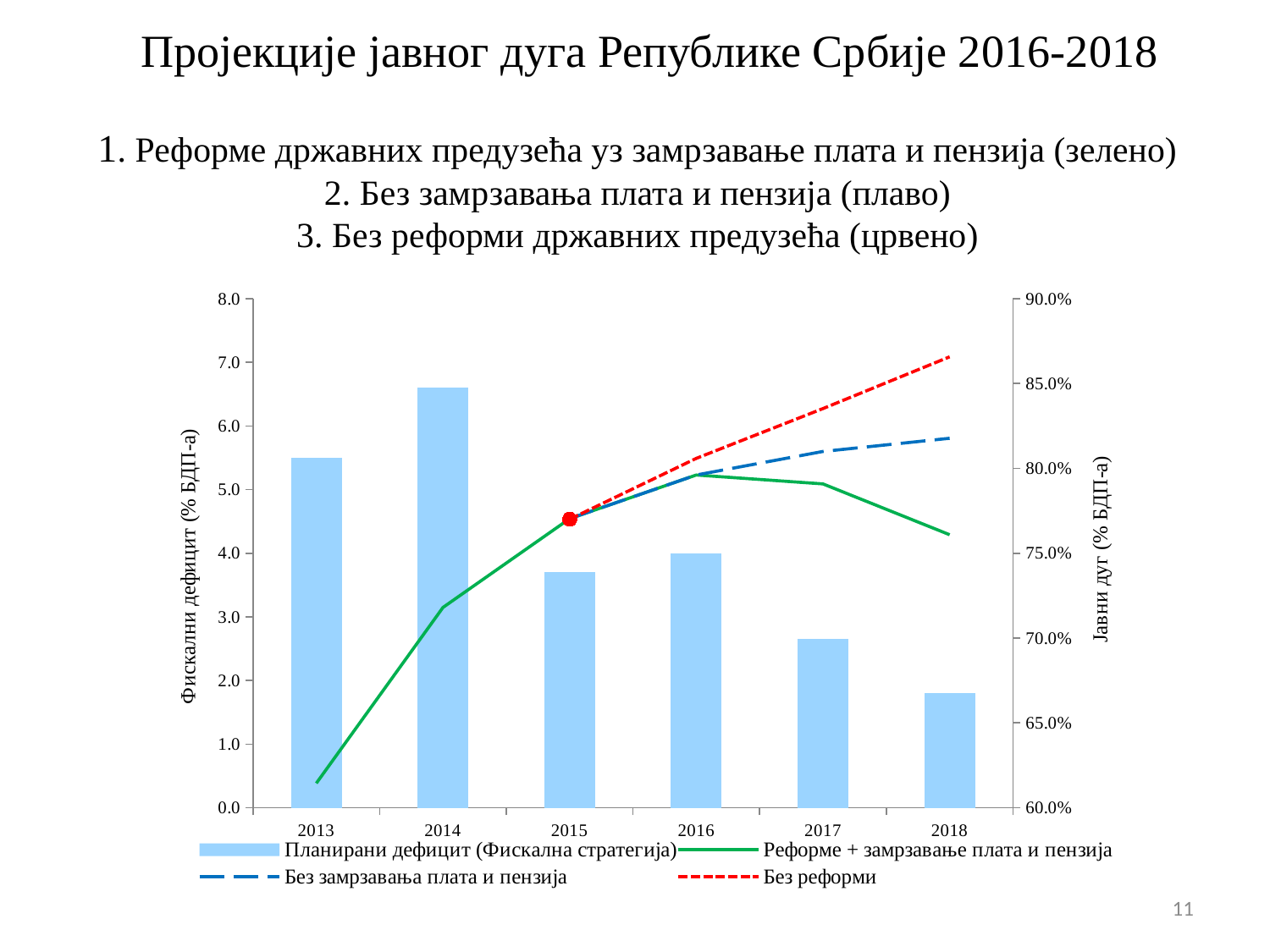
Which is larger, the planned deficit bar for 2013 or for 2015? 2013 What kind of chart is shown on the slide? A combination bar and line chart Is the 'Без реформи' (red dashed) line value for 2018 greater or less than 85.0%? greater What is the title of the slide containing the chart? Пројекције јавног дуга Републике Србије 2016-2018 Which year has the highest planned deficit bar (Планирани дефицит)? 2014 Is the planned deficit bar for 2017 greater or less than 3.0? less How many series does the legend list? 4 Is the planned deficit bar for 2018 greater or less than 2.0? less Does the 'Реформе + замрзавање плата и пензија' (green) line rise or fall from 2016 to 2018? fall Which year has the lowest planned deficit bar (Планирани дефицит)? 2018 How many years are shown on the x axis? 6